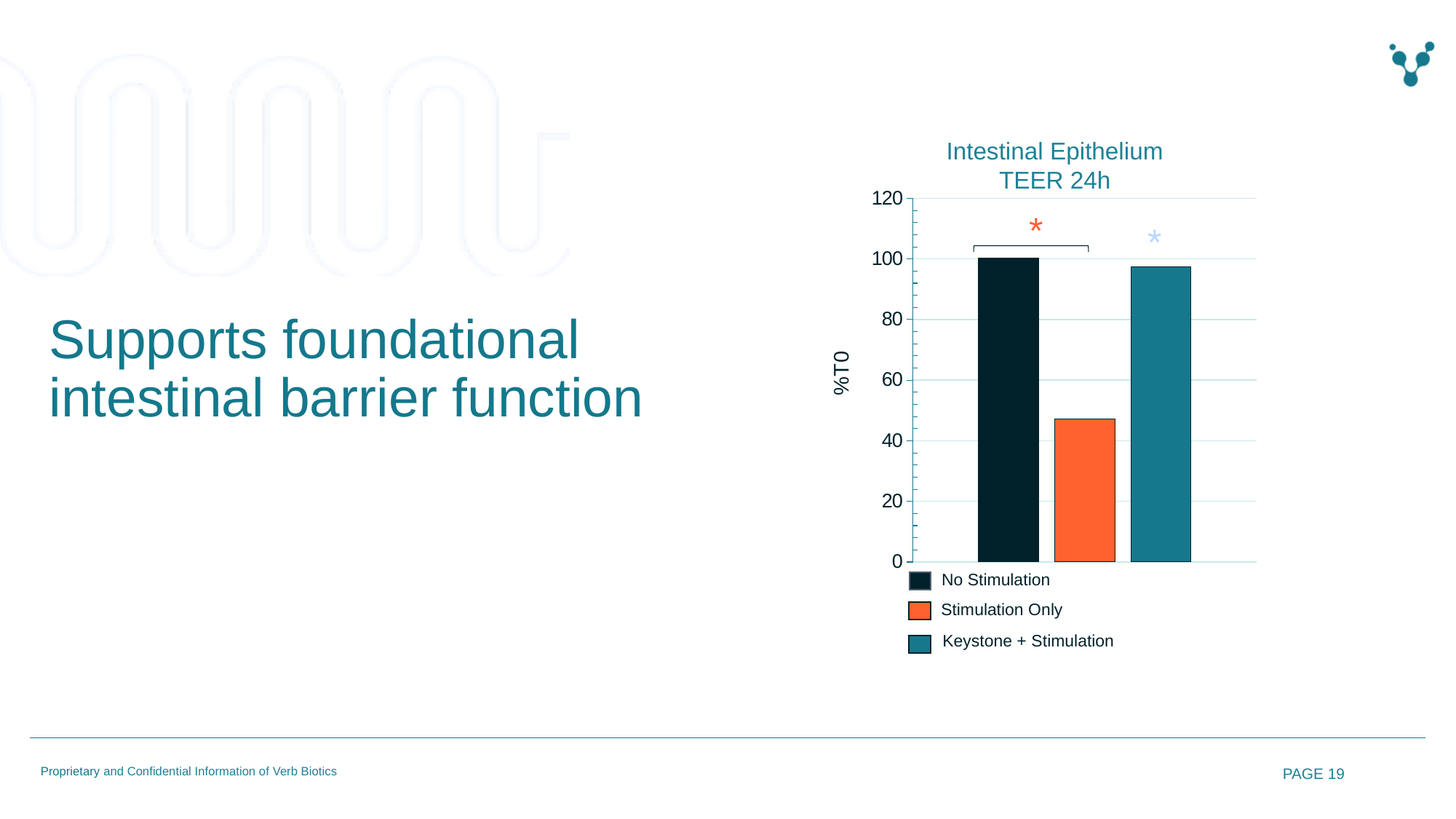
Which is larger, the value for Stimulation Only or the value for Keystone + Stimulation? Keystone + Stimulation How many entries does the chart's legend list? 3 What kind of chart is shown on the slide? bar chart Is the value for Stimulation Only greater or less than 40? greater How many bars are plotted in the chart? 3 Which is larger, the value for No Stimulation or the value for Stimulation Only? No Stimulation Is the value for Keystone + Stimulation greater or less than 80? greater Is the value for Stimulation Only greater or less than 60? less What is the label on the chart's y axis? %T0 Which condition has the lowest value in the chart? Stimulation Only What is the title of the chart? Intestinal Epithelium TEER 24h